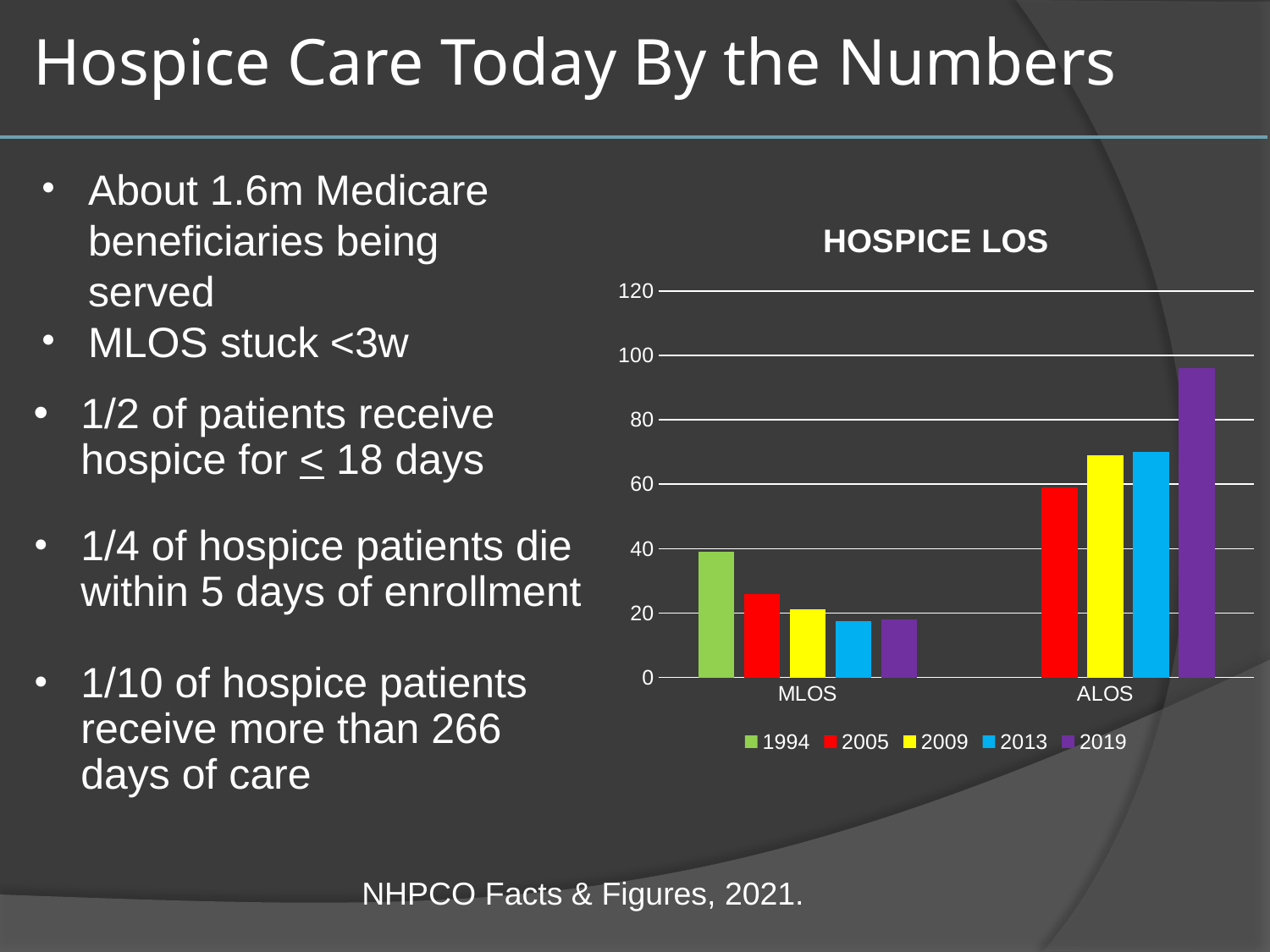
Which year has the highest bar in the MLOS category? 1994 Which colour represents the 2019 series in the legend? purple How many categories are shown on the x axis of the chart? 2 What is the title of the chart? HOSPICE LOS How many series does the chart's legend list? 5 Do the MLOS values rise or fall from 1994 to 2019? fall Is the value for 2019 in the ALOS category greater or less than 80? greater Is the value for 2013 in the MLOS category greater or less than 20? less In the MLOS category, which is larger: the 1994 bar or the 2005 bar? 1994 What kind of chart is shown on the slide? bar chart Which year has the highest bar in the ALOS category? 2019 Is the value for 2009 in the ALOS category greater or less than 60? greater